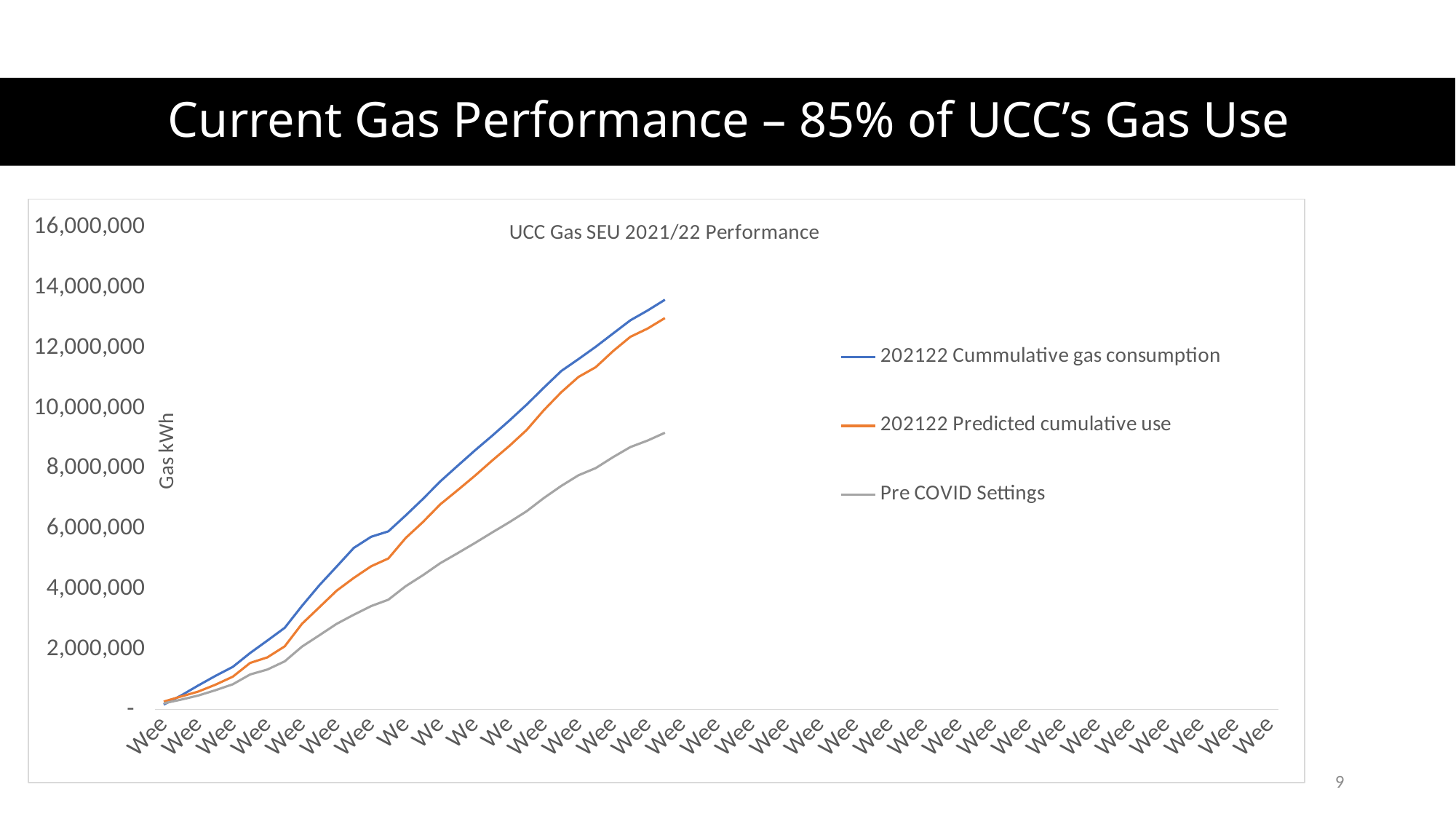
What is the label on the vertical axis of the chart? Gas kWh How many series does the legend list? 3 At the last plotted point, which is larger: 202122 Cummulative gas consumption or Pre COVID Settings? 202122 Cummulative gas consumption Which series reaches the highest value on the chart? 202122 Cummulative gas consumption Do the values of the 202122 Cummulative gas consumption series rise or fall along the x axis? rise What is the title of the chart? UCC Gas SEU 2021/22 Performance What kind of chart is shown on the slide? line chart Is the final plotted value of the Pre COVID Settings series greater or less than 10,000,000? less At the last plotted point, which is larger: 202122 Cummulative gas consumption or 202122 Predicted cumulative use? 202122 Cummulative gas consumption Is the final plotted value of the 202122 Cummulative gas consumption series greater or less than 12,000,000? greater Is the final plotted value of the Pre COVID Settings series greater or less than 8,000,000? greater Which series has the lowest values on the chart? Pre COVID Settings